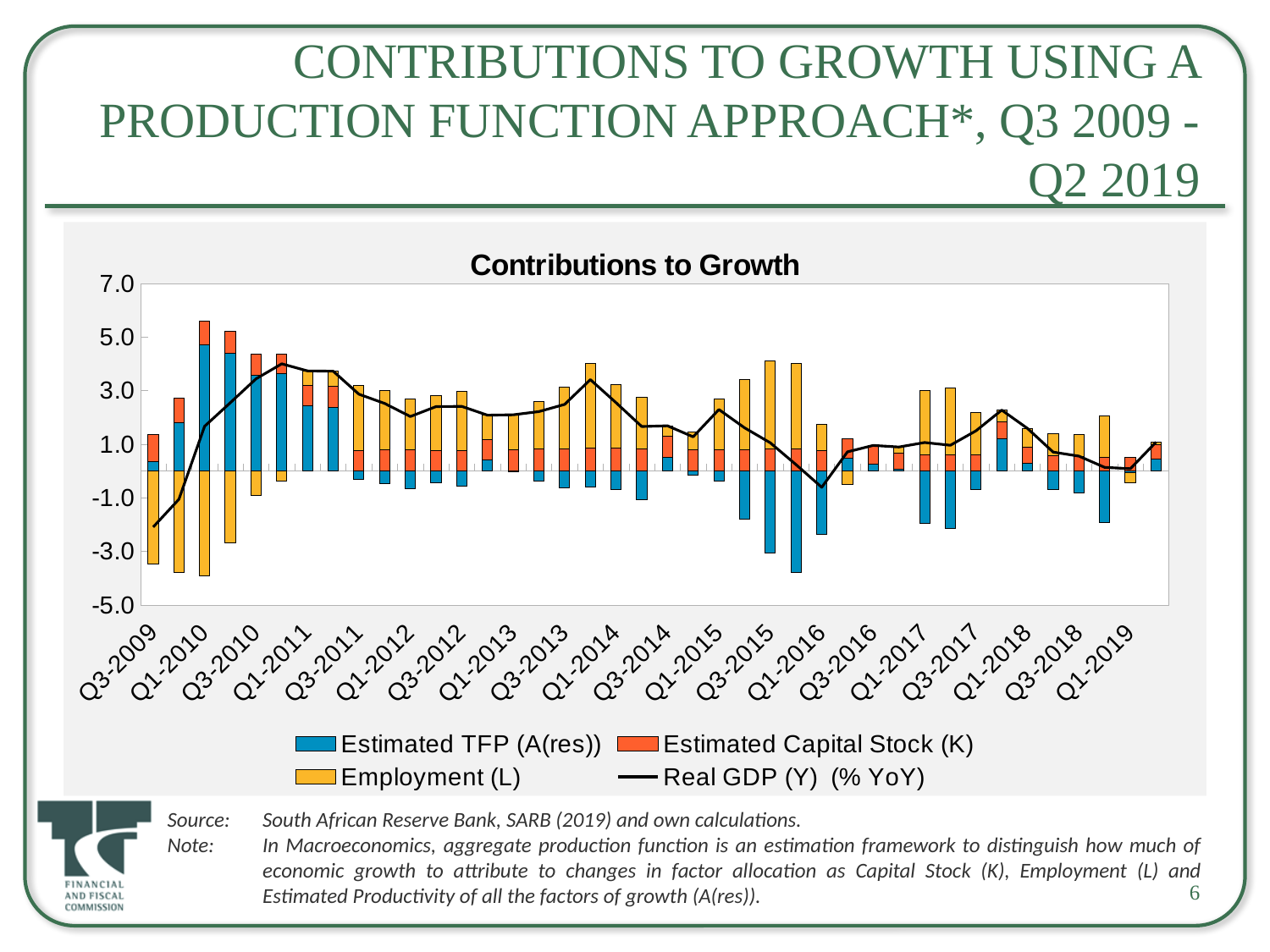
How many quarter labels are shown on the x axis? 20 What kind of chart is shown on the slide? Stacked bar chart with a line Is the Estimated TFP (A(res)) contribution for Q1-2016 greater or less than -1.0? less In which quarter is the Real GDP (Y) (% YoY) line at its lowest? Q3-2009 Does the Real GDP (Y) (% YoY) line rise or fall from Q3-2009 to Q1-2011? rise Is the Real GDP (Y) (% YoY) value for Q1-2011 greater or less than 3.0? greater Is the Real GDP (Y) (% YoY) value for Q1-2018 greater or less than 1.0? greater What is the title of the chart? Contributions to Growth How many series does the legend list? 4 Which series is plotted as a black line? Real GDP (Y) (% YoY)